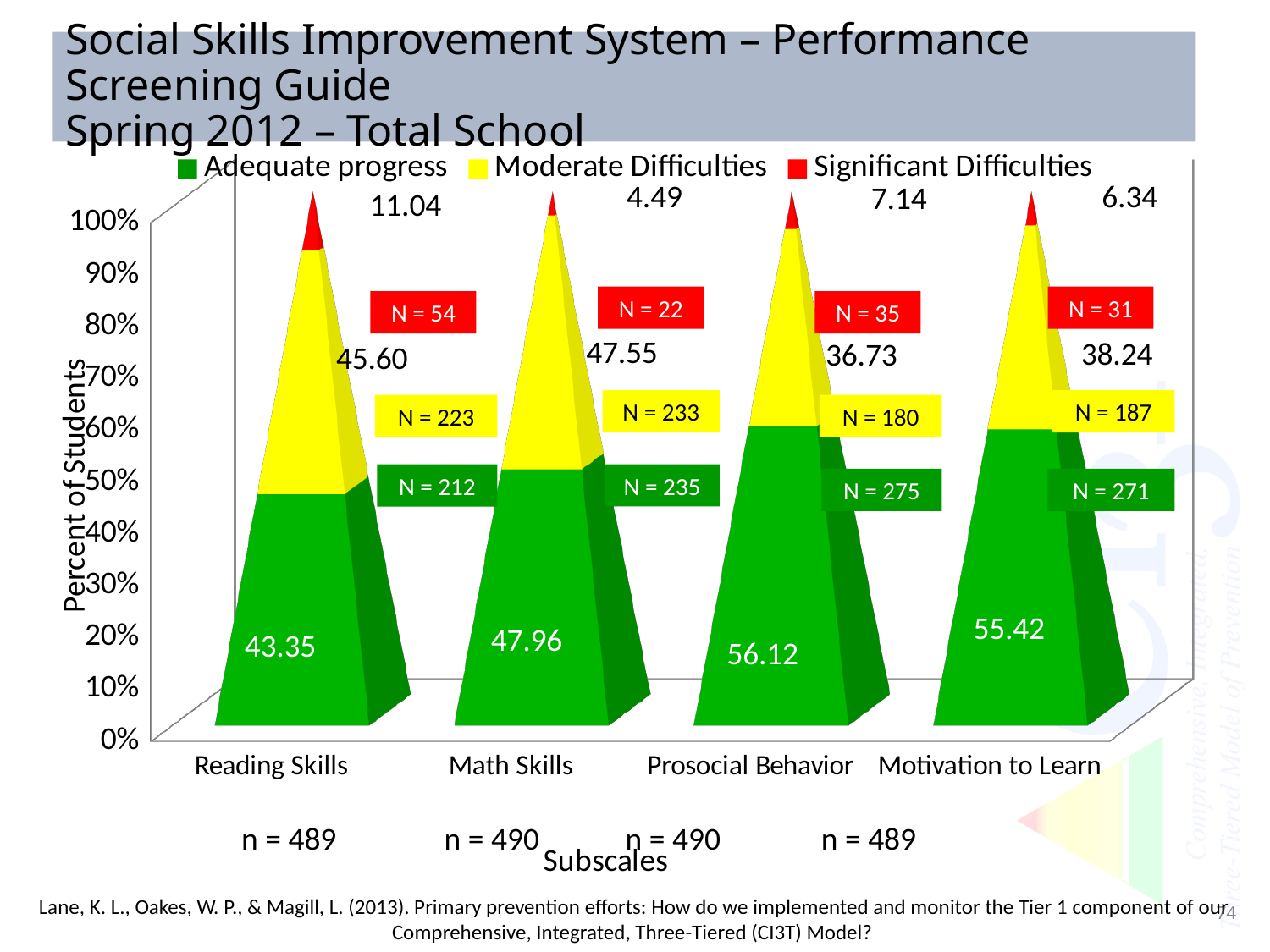
Which subscale has the highest Adequate progress value? Prosocial Behavior What is the Adequate progress value for Motivation to Learn? 55.42 What is the difference between the Significant Difficulties values for Reading Skills and Math Skills? 6.55 How many series does the legend list? 3 How many subscales are shown on the x axis? 4 What is the Adequate progress value for Prosocial Behavior? 56.12 What is the Significant Difficulties value for Math Skills? 4.49 Which is larger, the Moderate Difficulties value for Math Skills or for Motivation to Learn? Math Skills Which subscale has the lowest Significant Difficulties value? Math Skills What is the label of the y axis? Percent of Students Which subscale has the lowest Adequate progress value? Reading Skills What is the Moderate Difficulties value for Reading Skills? 45.60